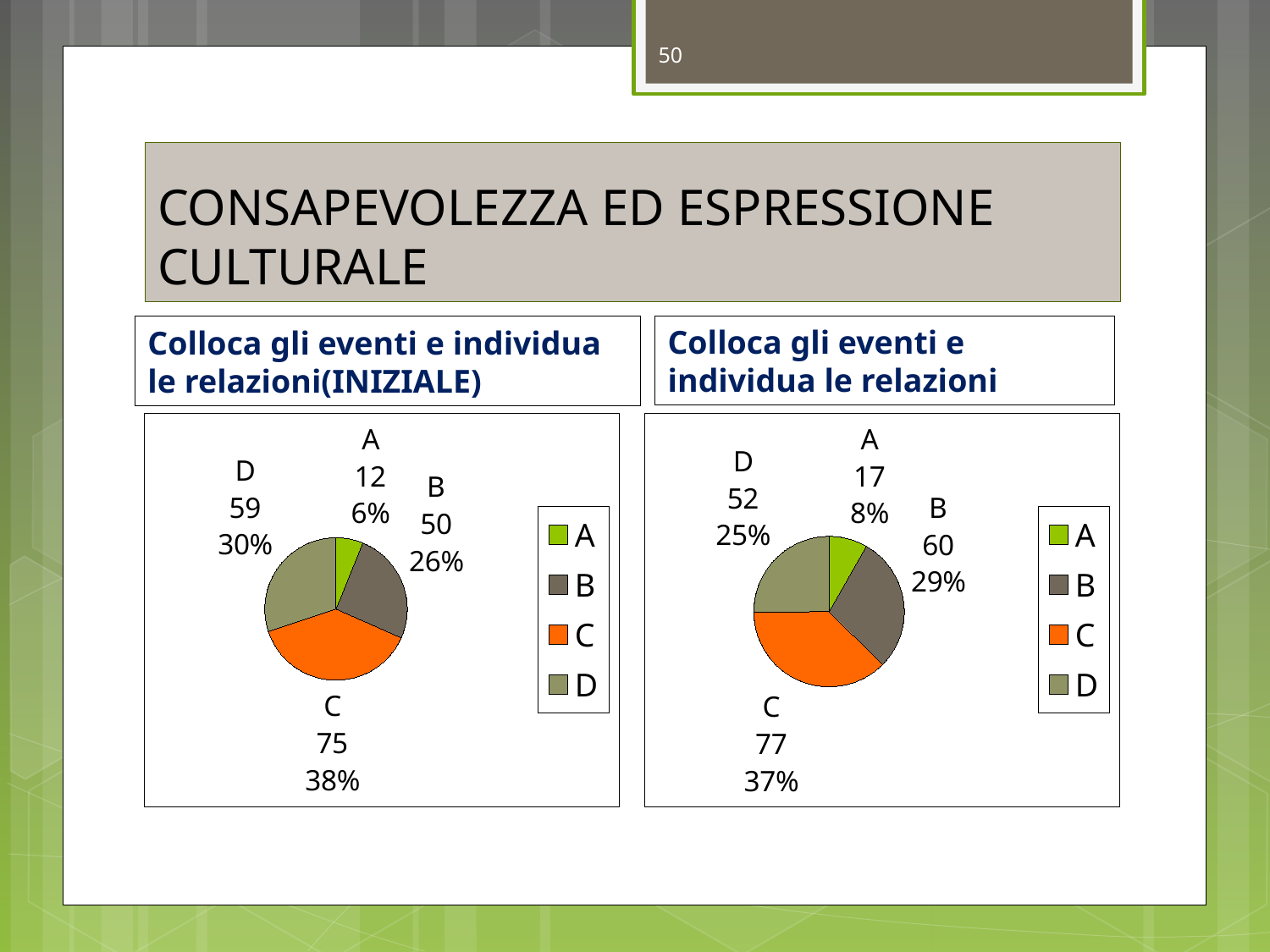
How many categories does the left pie chart (INIZIALE) show? 4 What type of chart is used on the right side of the slide? Pie chart In the left pie chart (INIZIALE), which category has the largest value? C In the right pie chart, what is the value for category B? 60 In the left pie chart (INIZIALE), what is the difference between the values for D and B? 9 In the left pie chart (INIZIALE), what percentage share does category D have? 30% In the right pie chart, which colour represents category C in the legend? Orange In the right pie chart, what is the difference between the values for C and D? 25 In the right pie chart, what percentage share does category A have? 8% In the right pie chart, which is larger, the value for B or the value for D? B In the left pie chart (INIZIALE), what is the value for category C? 75 In the right pie chart, which category has the smallest value? A